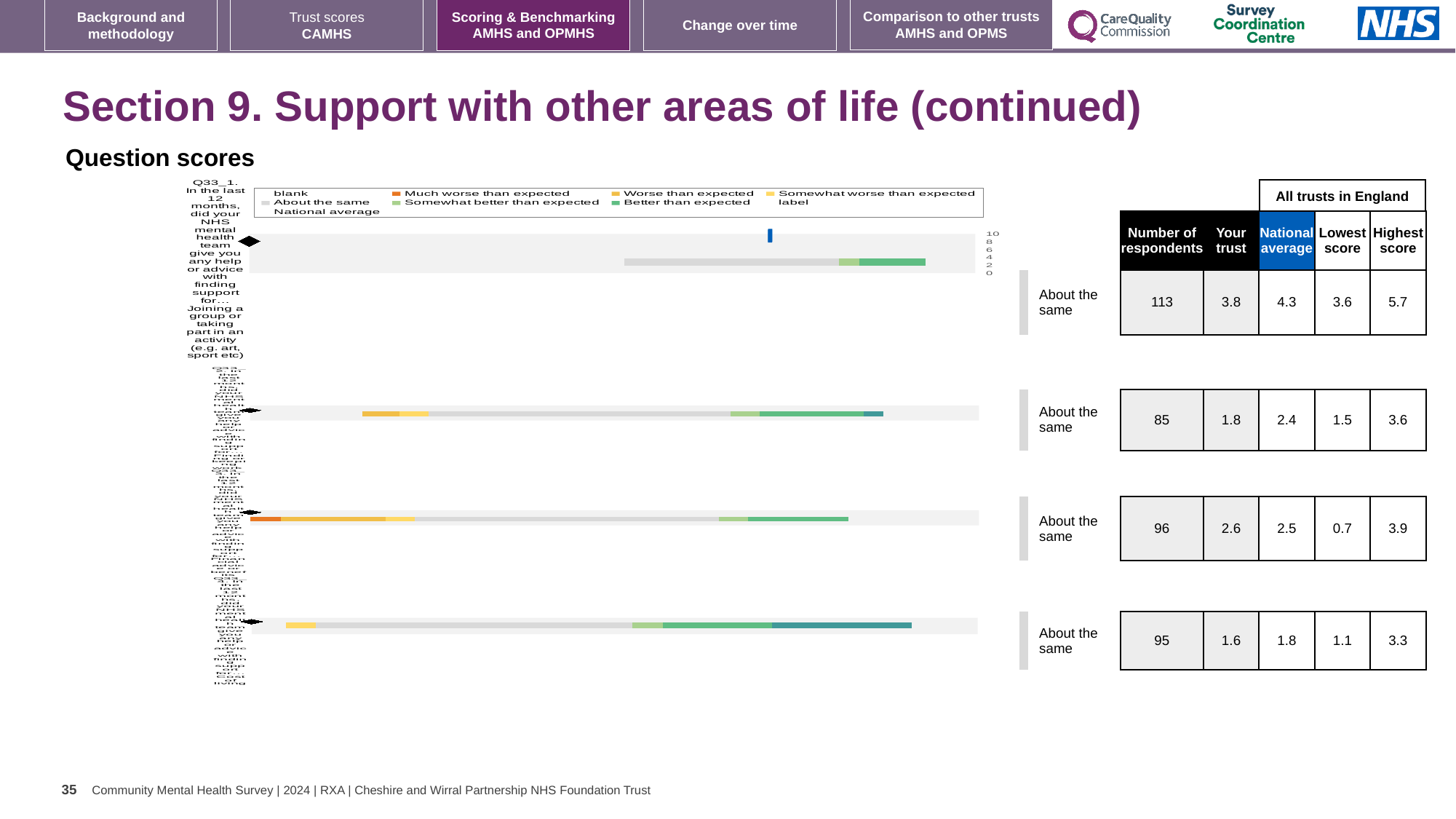
What colour does the legend assign to 'Better than expected'? green In the table beside the chart, which is larger for the first question (Q33_1): the 'Your trust' score or the national average? National average In the table beside the chart, what is the difference between the national average and the 'Your trust' score for the first question (Q33_1)? 0.5 In the table beside the chart, which of the four rows has the highest number of respondents? The first row (113) In the table beside the chart, what is the 'Your trust' score for the first question (Q33_1, joining a group or taking part in an activity)? 3.8 What benchmark label is shown next to each of the four bars in the chart? About the same In the table beside the chart, what is the national average for the first question (Q33_1)? 4.3 What kind of chart is shown under 'Question scores'? bar chart In the table beside the chart, what is the number of respondents for the first question (Q33_1)? 113 What colour does the legend assign to 'Much worse than expected'? orange In the table beside the chart, what is the highest score for the first question (Q33_1)? 5.7 How many question bars are plotted in the chart? 4